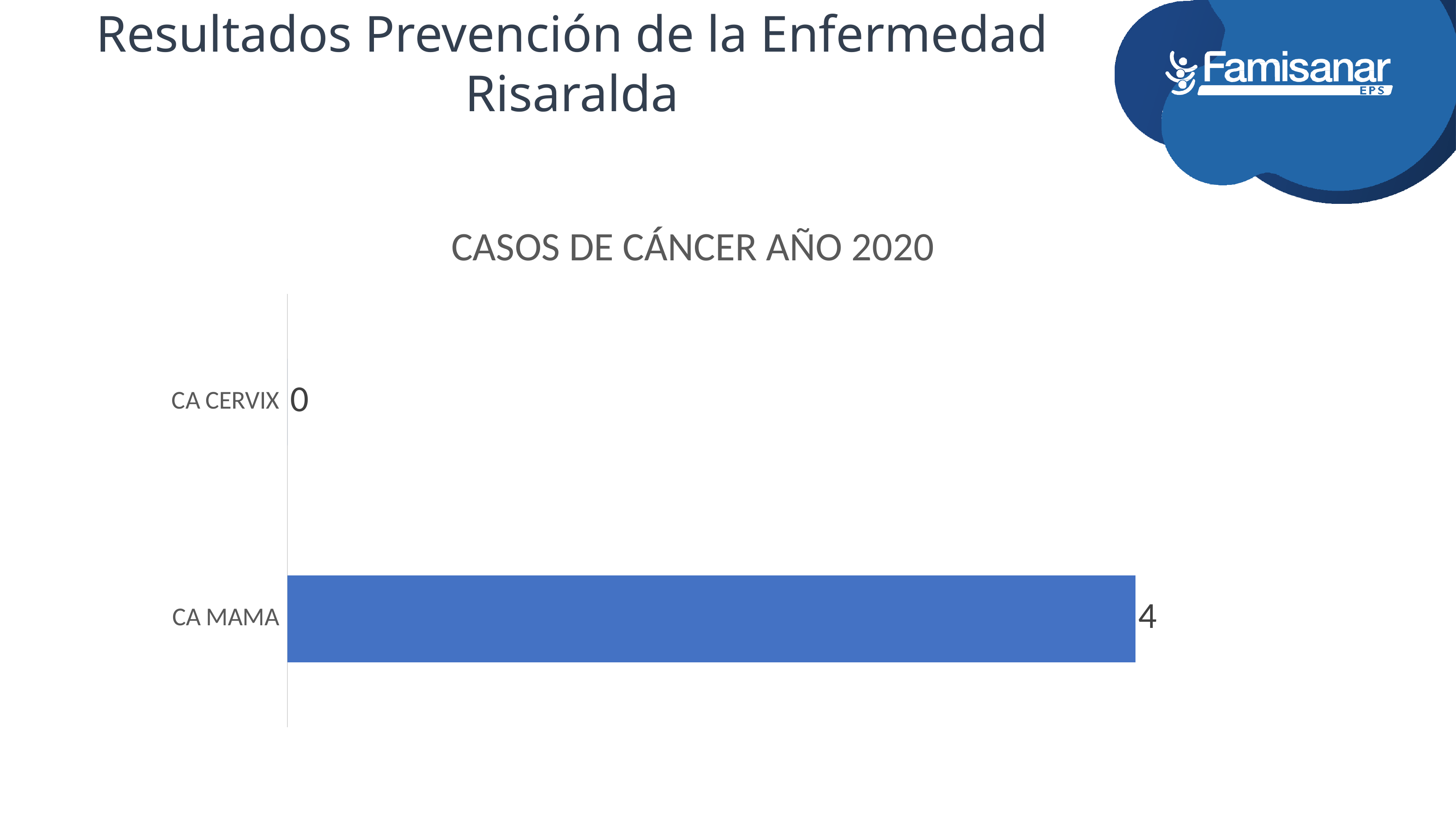
Which is larger, the value for CA MAMA or the value for CA CERVIX? CA MAMA What is the value for CA CERVIX? 0 Which category has the lowest value? CA CERVIX How many categories are shown in the chart? 2 What colour is the bar for CA MAMA? blue What kind of chart is shown on the slide? bar chart What is the title of the chart? CASOS DE CÁNCER AÑO 2020 Which category has the highest value? CA MAMA What is the value for CA MAMA? 4 What is the difference between the values for CA MAMA and CA CERVIX? 4